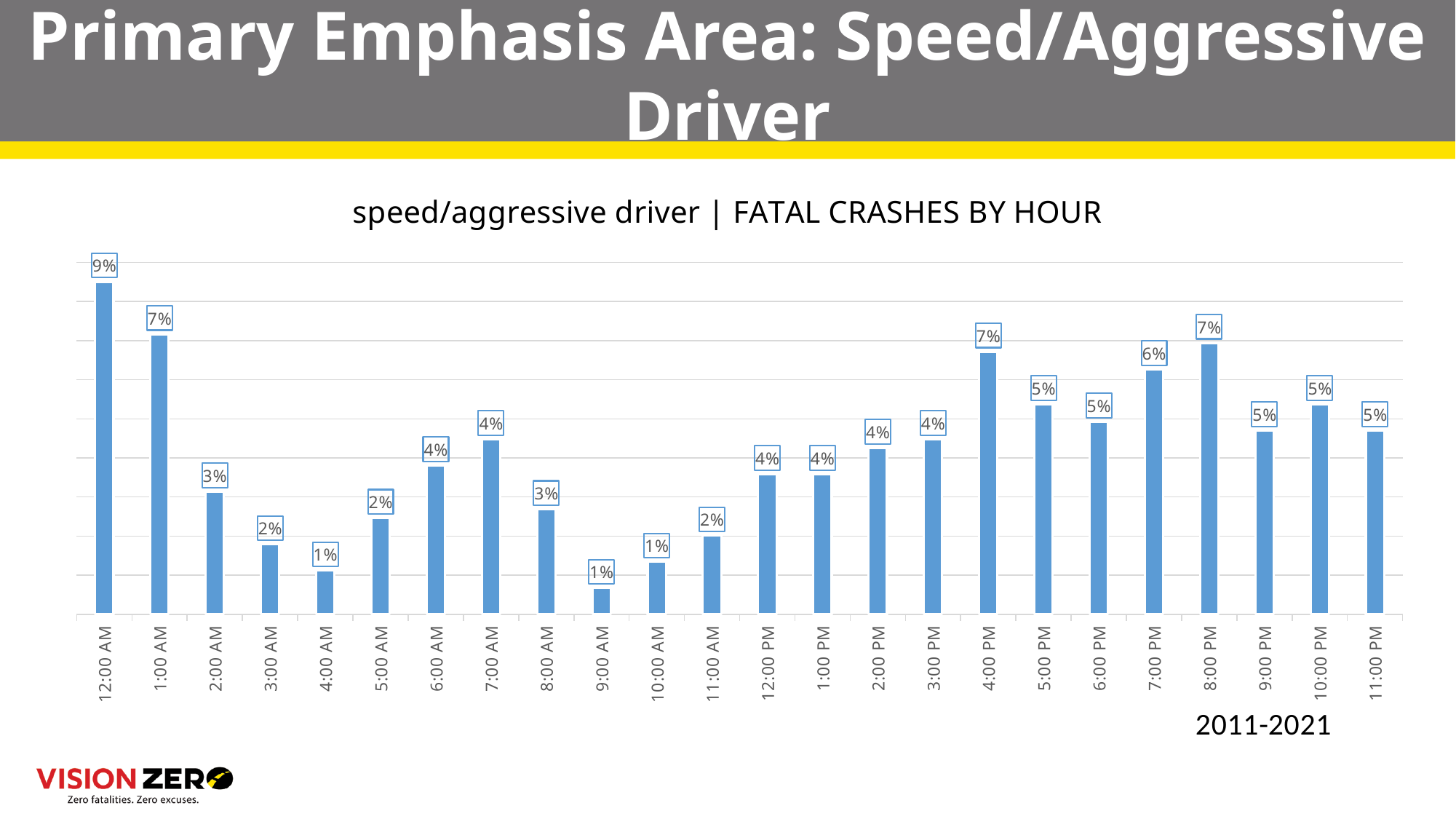
What is the value shown for 4:00 PM? 7% Which is larger, the value for 2:00 AM or the value for 6:00 AM? 6:00 AM What is the difference between the values for 8:00 PM and 9:00 PM? 2% Which hour has the highest share of fatal crashes? 12:00 AM Which is larger, the value for 1:00 AM or the value for 5:00 PM? 1:00 AM What is the value shown for 9:00 AM? 1% What is the difference between the values for 12:00 AM and 1:00 AM? 2% What is the value shown for 7:00 PM? 6% How many hour categories are shown on the x axis? 24 Do the values rise or fall from 12:00 AM to 4:00 AM? Fall What percentage of fatal crashes occurred at 12:00 AM? 9% What kind of chart is shown on the slide? Bar chart